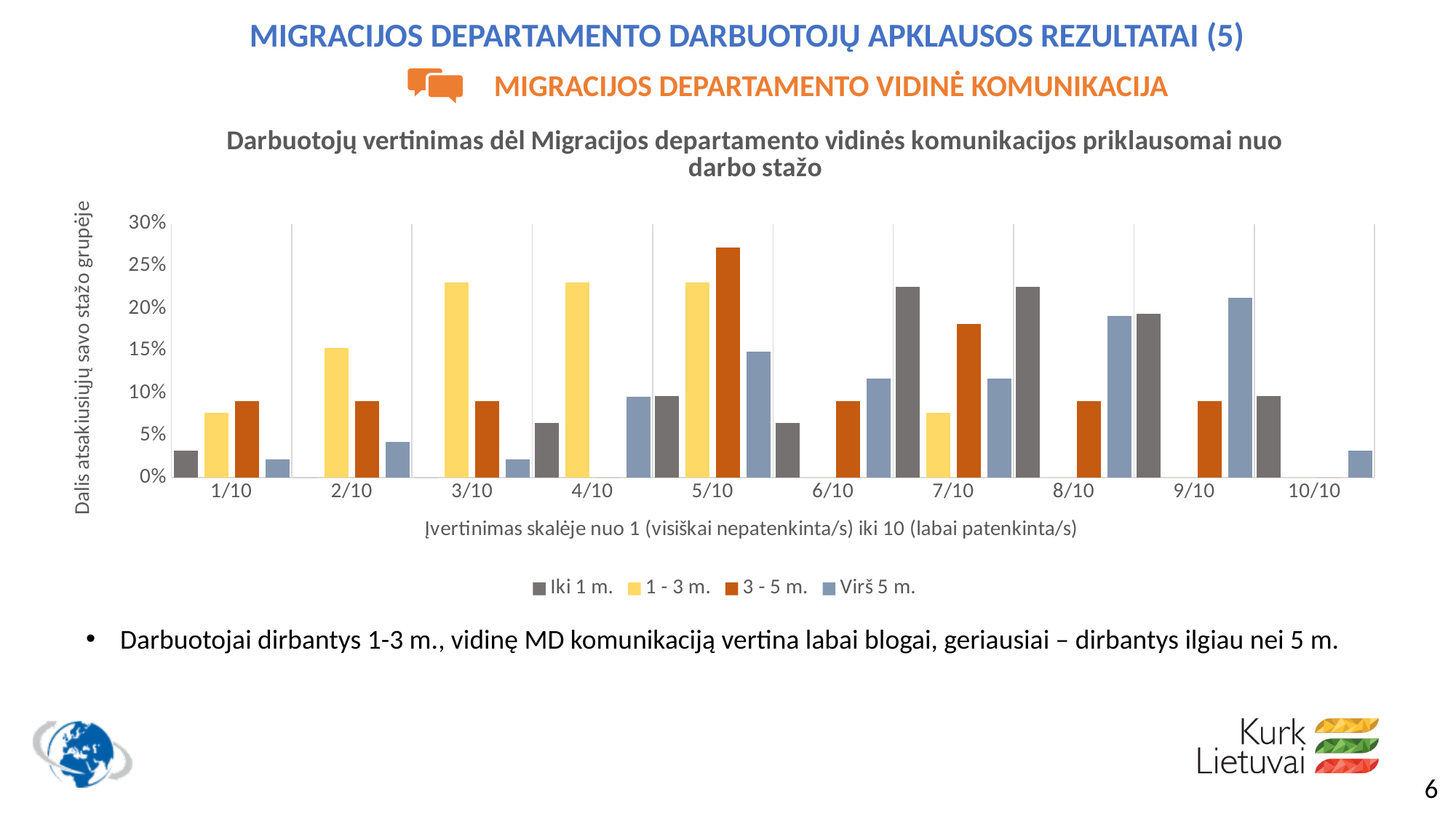
What is the label of the chart's y axis? Dalis atsakiusiųjų savo stažo grupėje At 7/10, which series has the larger value: Iki 1 m. or 1 - 3 m.? Iki 1 m. How many series does the chart legend list? 4 Is the value for the Iki 1 m. series at 8/10 greater or less than 20%? greater At 9/10, which series has the larger value: Virš 5 m. or 3 - 5 m.? Virš 5 m. Is the value for the Virš 5 m. series at 1/10 greater or less than 5%? less Is the value for the 1 - 3 m. series at 3/10 greater or less than 20%? greater What kind of chart is shown on the slide? Bar chart Which colour represents the 1 - 3 m. series in the chart legend? Yellow How many rating categories are shown along the x axis of the chart? 10 At which rating does the 3 - 5 m. series reach its highest value? 5/10